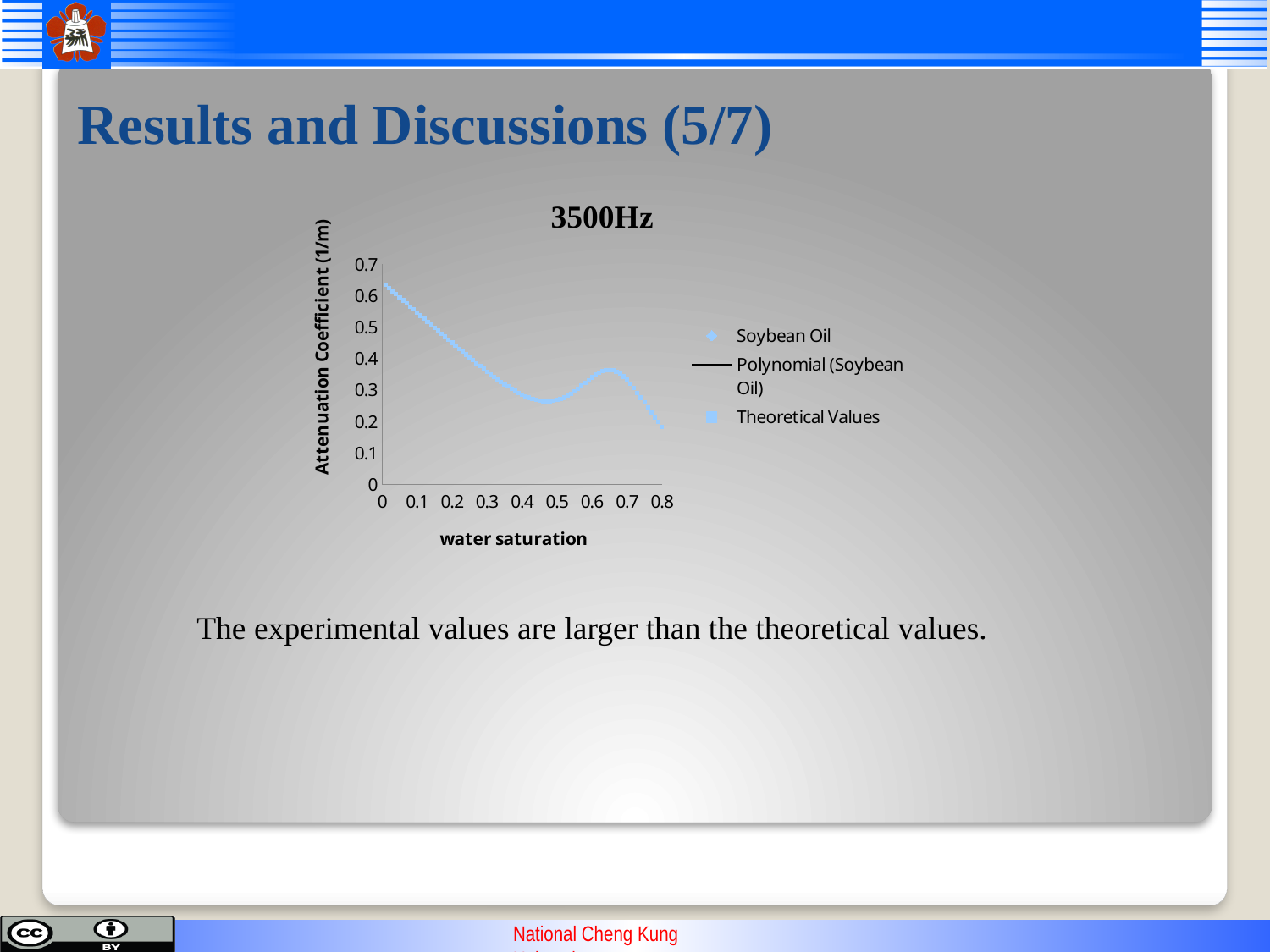
Is the attenuation coefficient at water saturation 0.2 greater or less than 0.3? greater What is the title of the chart? 3500Hz Which has the larger attenuation coefficient: water saturation 0 or water saturation 0.8? water saturation 0 Is the attenuation coefficient at water saturation 0.8 greater or less than 0.3? less How many entries does the chart legend list? 3 Is the attenuation coefficient at water saturation 0 greater or less than 0.5? greater What kind of chart is shown on the slide? scatter chart What is the highest value shown on the y axis of the chart? 0.7 Does the attenuation coefficient rise or fall as water saturation increases from 0 to 0.5? fall What is the label of the x axis of the chart? water saturation